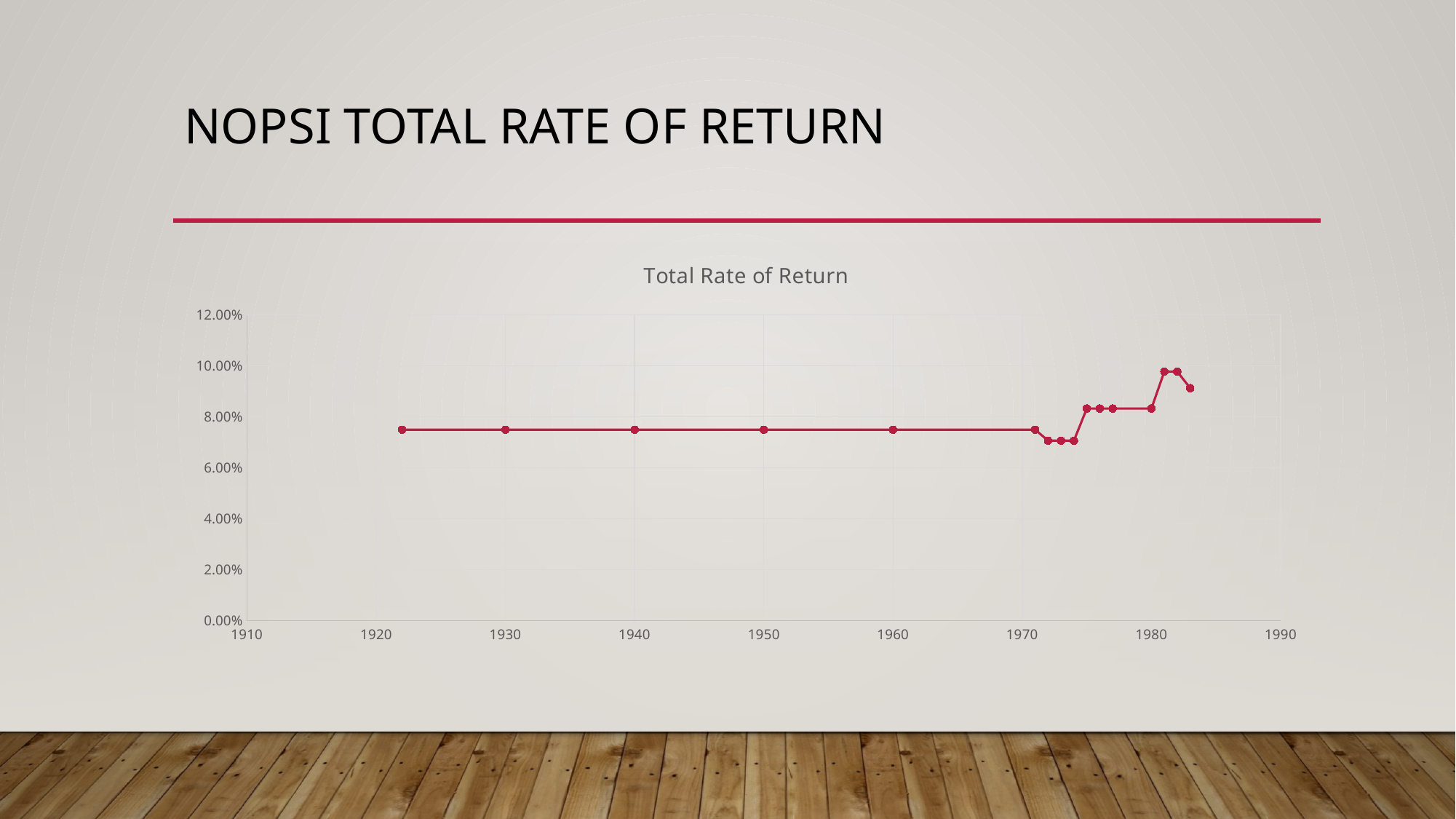
Is the value for 1950 greater or less than 6.00%? greater Is the value for 1950 greater or less than 8.00%? less Which is larger, the value for 1975 or the value for 1972? 1975 Is the value for 1983 greater or less than 8.00%? greater What kind of chart is shown on the slide? Line chart Does the value rise or fall between 1982 and 1983? fall Which is larger, the value for 1983 or the value for 1950? 1983 What is the title of the chart? Total Rate of Return Does the value rise, fall or stay flat between 1922 and 1960? stays flat What is the highest value shown on the vertical axis? 12.00%